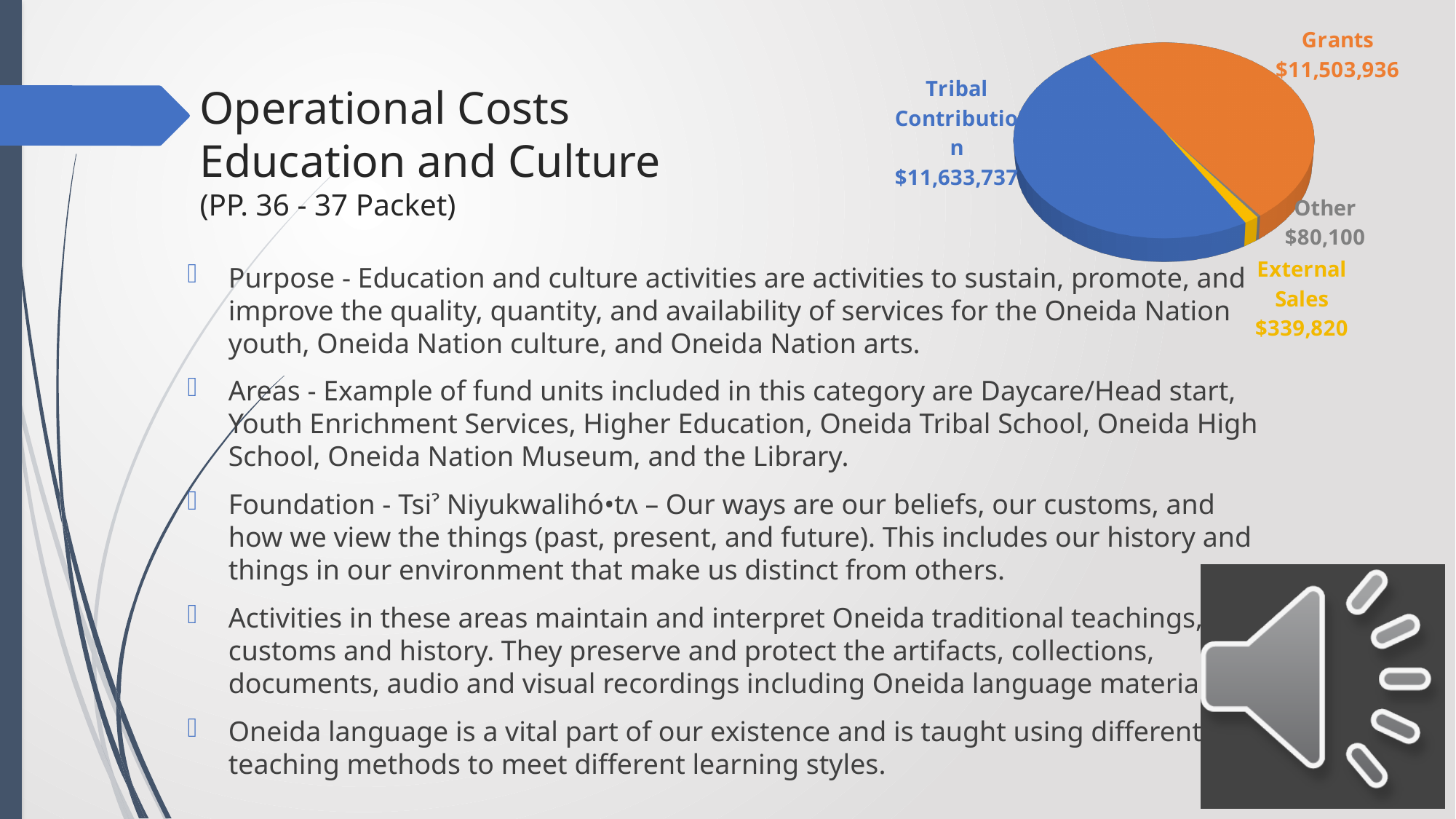
Which category has the smallest slice in the pie chart? Other What type of chart is shown on the slide? Pie chart What is the value for Other in the pie chart? $80,100 What is the value for External Sales in the pie chart? $339,820 What is the value for Tribal Contribution in the pie chart? $11,633,737 Which is larger, Grants or Tribal Contribution? Tribal Contribution What is the value for Grants in the pie chart? $11,503,936 What is the difference between Tribal Contribution and Grants? $129,801 What is the difference between External Sales and Other? $259,720 How many slices does the pie chart have? 4 Which category has the largest value in the pie chart? Tribal Contribution What colour is the Grants slice in the pie chart? Orange